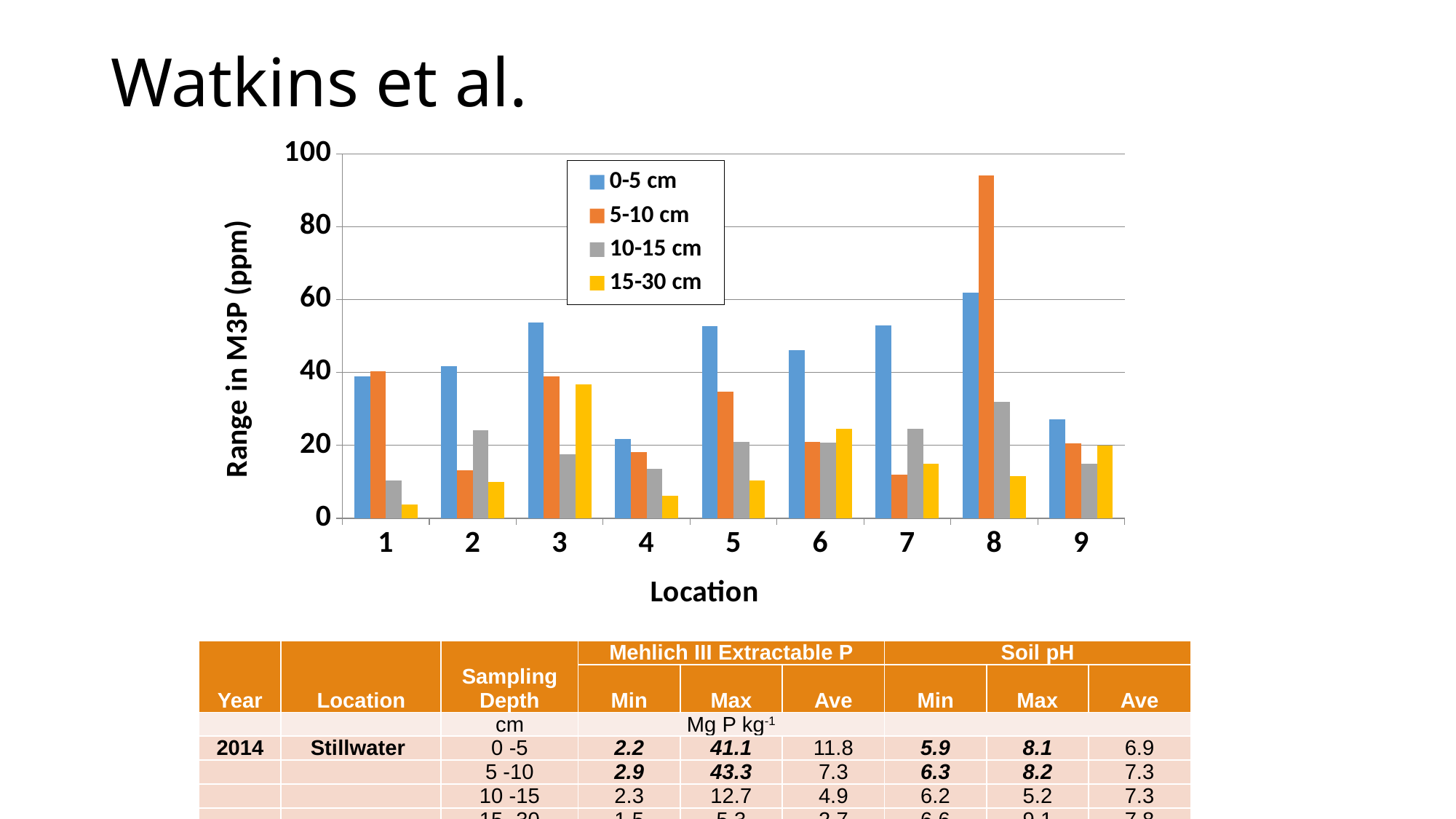
Is the 5-10 cm value for location 8 greater or less than 80? greater At location 5, which is larger: the 0-5 cm value or the 5-10 cm value? 0-5 cm Is the 15-30 cm value for location 3 greater or less than 20? greater At location 2, which is larger: the 5-10 cm value or the 10-15 cm value? 10-15 cm Is the 0-5 cm value for location 4 greater or less than 40? less Which location has the lowest 0-5 cm value? 4 What is the title of the chart's y axis? Range in M3P (ppm) Which location has the highest 5-10 cm value? 8 Which location has the highest 0-5 cm value? 8 What kind of chart is shown on the slide? bar chart How many locations are shown on the x axis of the chart? 9 How many series does the chart legend list? 4